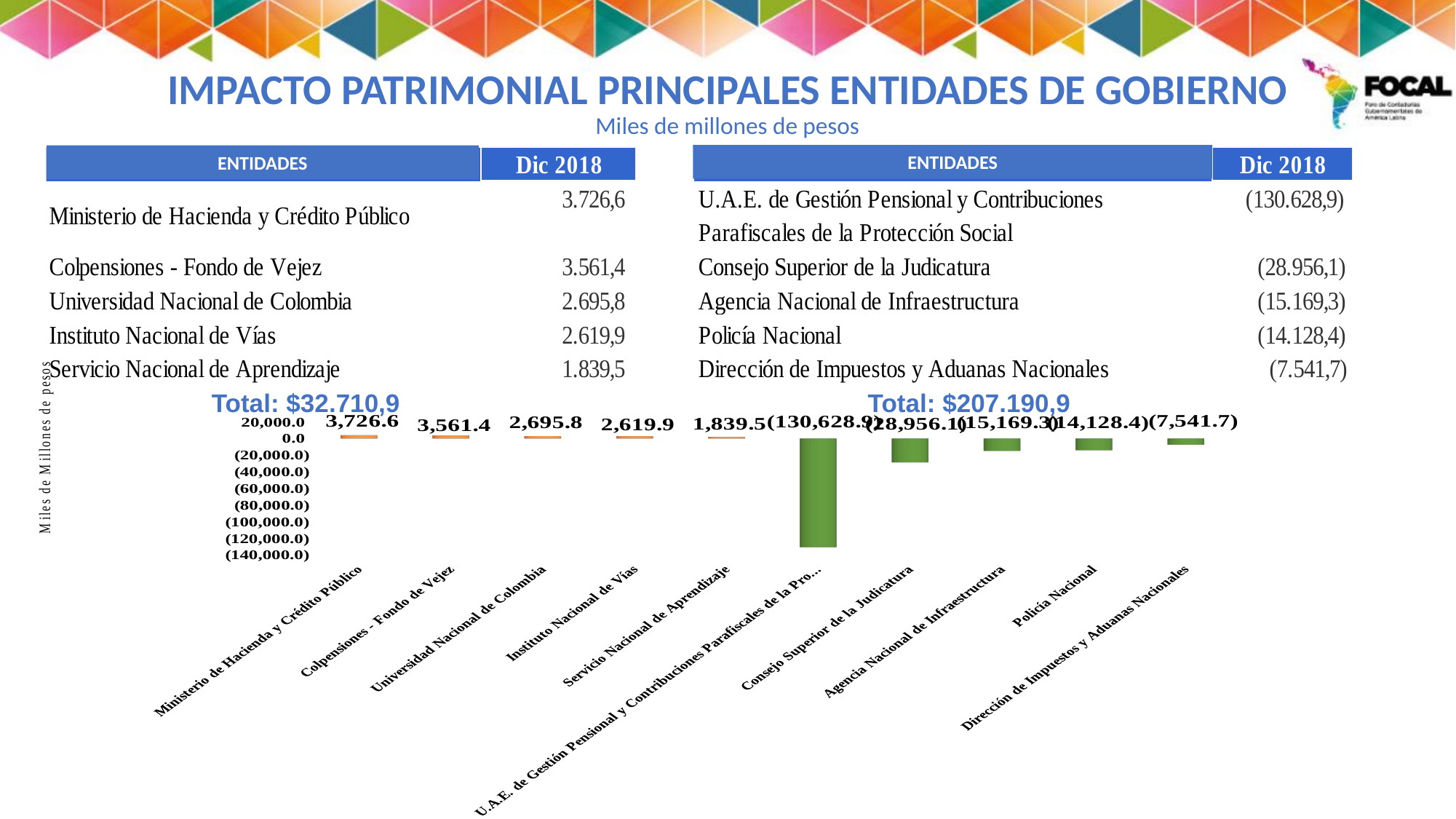
What is the value shown for Colpensiones - Fondo de Vejez in the bar chart? 3,561.4 What is the value shown for Policía Nacional in the bar chart? (14,128.4) Which entity has the highest value in the bar chart? Ministerio de Hacienda y Crédito Público How many entities (categories) are plotted in the bar chart? 10 Which has a larger value in the bar chart, Universidad Nacional de Colombia or Instituto Nacional de Vías? Universidad Nacional de Colombia What is the value shown for Ministerio de Hacienda y Crédito Público in the bar chart? 3,726.6 Which entity has the lowest (most negative) value in the bar chart? U.A.E. de Gestión Pensional y Contribuciones Parafiscales de la Protección Social What is the value shown for Consejo Superior de la Judicatura in the bar chart? (28,956.1) What is the value shown for Dirección de Impuestos y Aduanas Nacionales in the bar chart? (7,541.7) What unit is given on the vertical axis label of the bar chart? Miles de Millones de pesos What kind of chart is shown on the slide? bar chart What is the difference between the values for Ministerio de Hacienda y Crédito Público and Servicio Nacional de Aprendizaje in the bar chart? 1,887.1